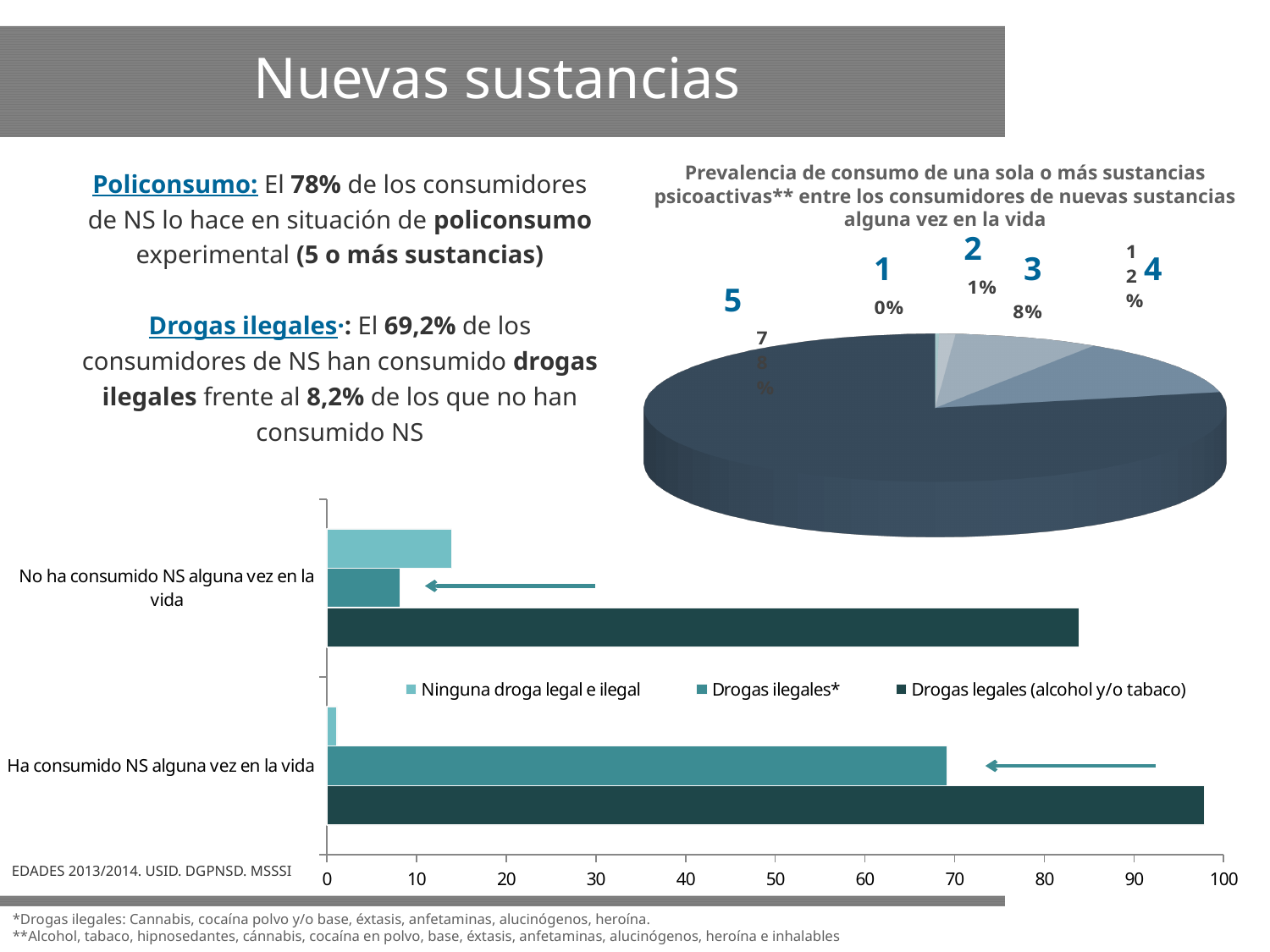
How many categories does the bar chart at the bottom of the slide show? 2 What kind of chart is the chart at the bottom of the slide with the categories "No ha consumido NS alguna vez en la vida" and "Ha consumido NS alguna vez en la vida"? bar chart In the pie chart, what share does the slice labelled 3 have? 8% In the bar chart at the bottom of the slide, is the value of "Drogas ilegales*" for "No ha consumido NS alguna vez en la vida" greater or less than 10? less In the bar chart at the bottom of the slide, which series has the highest value for "Ha consumido NS alguna vez en la vida"? Drogas legales (alcohol y/o tabaco) In the bar chart at the bottom of the slide, is the value of "Drogas ilegales*" for "Ha consumido NS alguna vez en la vida" greater or less than 60? greater In the pie chart, what share does the slice labelled 5 have? 78% In the pie chart, what is the difference between the share of slice 5 and the share of slice 3? 70% How many slices does the pie chart have? 5 What kind of chart is the chart titled "Prevalencia de consumo de una sola o más sustancias psicoactivas** entre los consumidores de nuevas sustancias alguna vez en la vida"? pie chart How many series does the legend of the bar chart at the bottom of the slide list? 3 In the pie chart, which slice is the largest? 5